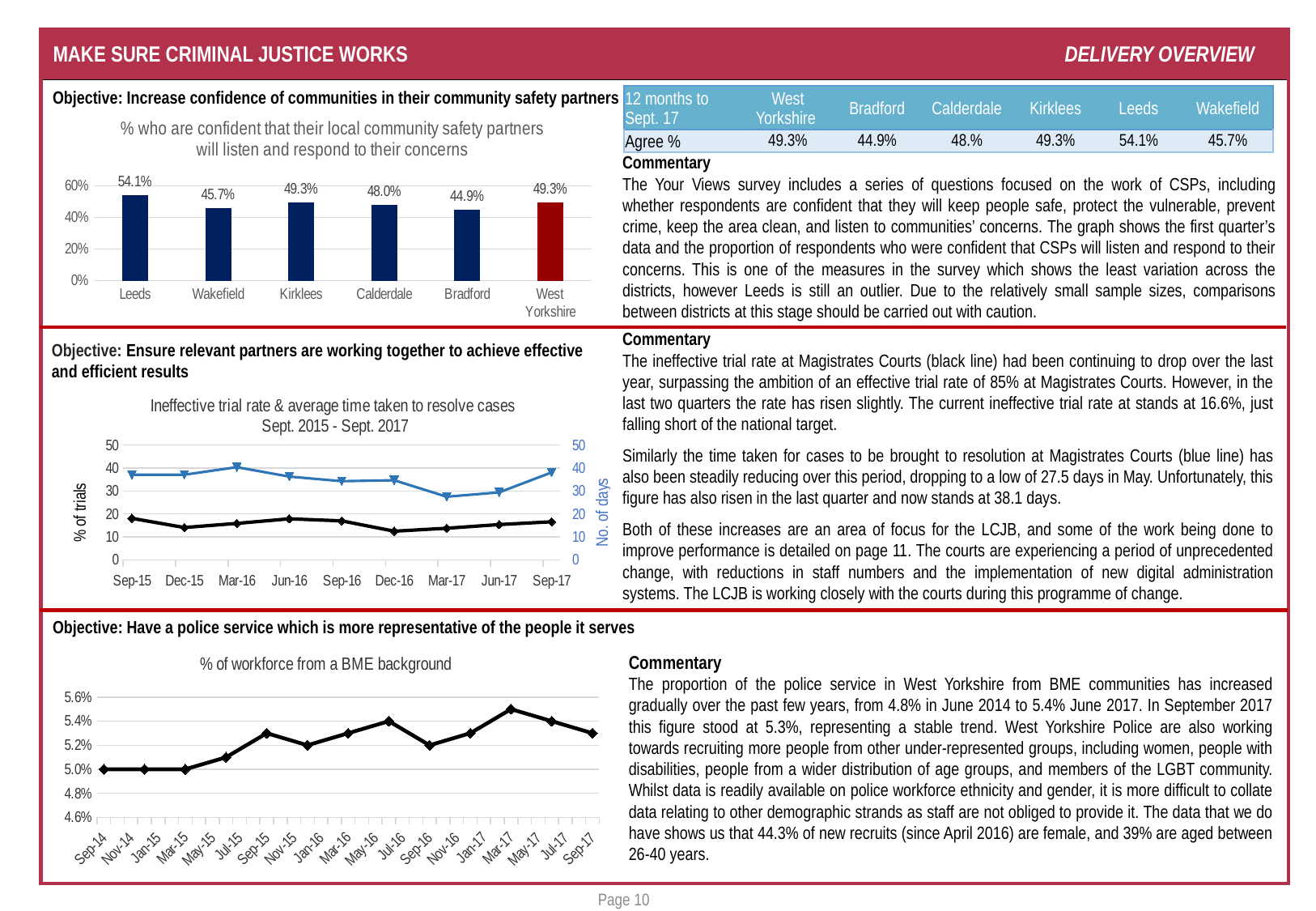
How many categories are shown in the bar chart '% who are confident that their local community safety partners will listen and respond to their concerns'? 6 In the chart '% of workforce from a BME background', is the value for Sep-14 greater or less than 5.2%? less In the bar chart '% who are confident that their local community safety partners will listen and respond to their concerns', which category has the lowest value? Bradford In the chart 'Ineffective trial rate & average time taken to resolve cases Sept. 2015 - Sept. 2017', is the value of the black line at Dec-16 greater or less than 20? less What kind of chart is '% of workforce from a BME background'? Line chart In the bar chart '% who are confident that their local community safety partners will listen and respond to their concerns', which is larger, the value for Calderdale or the value for Wakefield? Calderdale How many data points are plotted along the x axis in the chart 'Ineffective trial rate & average time taken to resolve cases Sept. 2015 - Sept. 2017'? 9 In the bar chart '% who are confident that their local community safety partners will listen and respond to their concerns', what is the value for Leeds? 54.1% In the bar chart '% who are confident that their local community safety partners will listen and respond to their concerns', what is the difference between the values for Leeds and Bradford? 9.2 percentage points In the bar chart '% who are confident that their local community safety partners will listen and respond to their concerns', which district has the highest value? Leeds In the bar chart '% who are confident that their local community safety partners will listen and respond to their concerns', what is the value for Bradford? 44.9% What kind of chart is '% who are confident that their local community safety partners will listen and respond to their concerns'? Bar chart